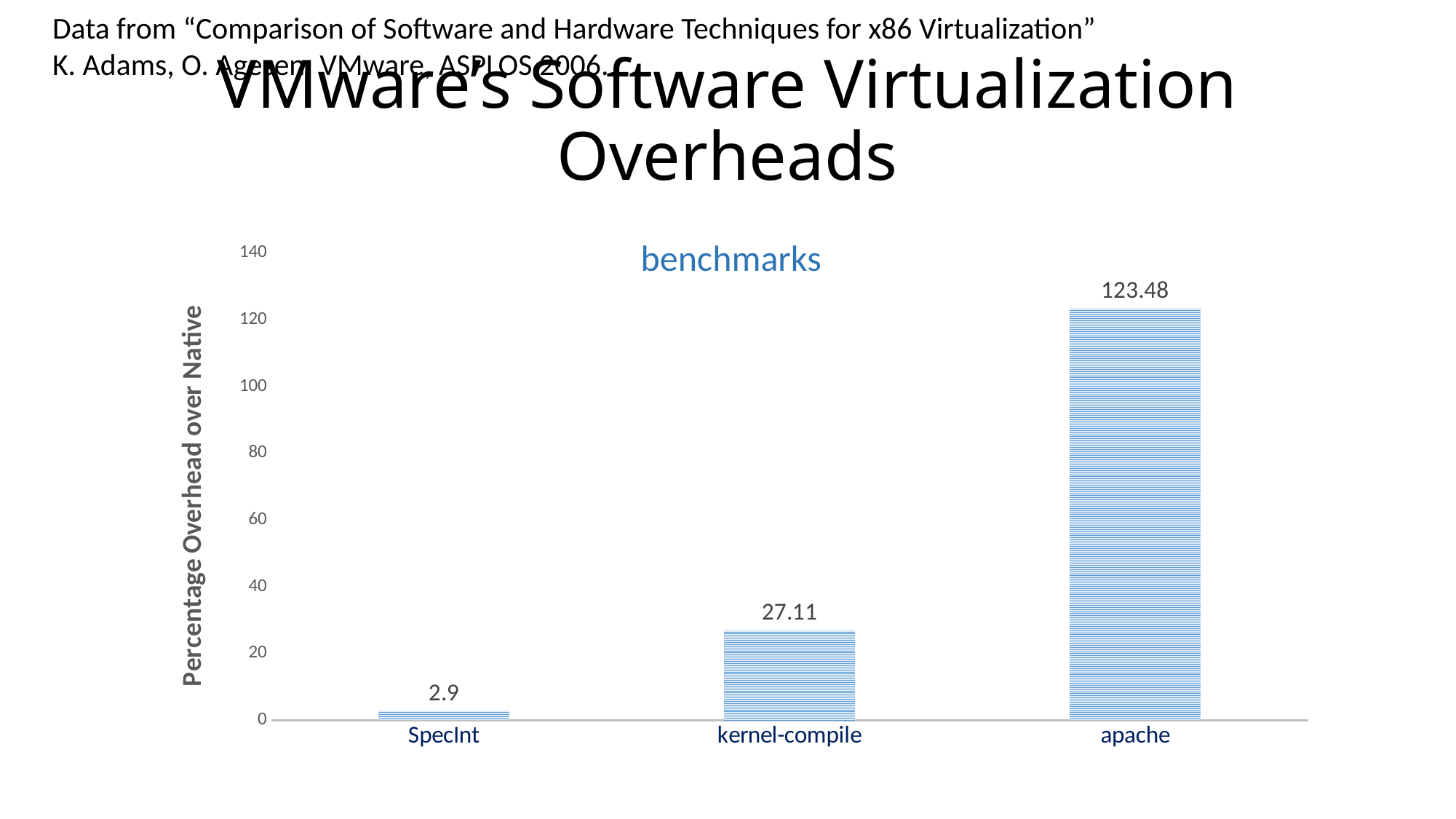
What is the value for apache? 123.48 What is the difference between the values for kernel-compile and SpecInt? 24.21 What is the difference between the values for apache and kernel-compile? 96.37 What is the value for kernel-compile? 27.11 Is the value for apache greater or less than 120? greater Which benchmark has the lowest percentage overhead over native? SpecInt How many benchmarks are shown on the x axis? 3 What is the value for SpecInt? 2.9 Which benchmark has the highest percentage overhead over native? apache What kind of chart is shown on the slide? bar chart What is the label of the y axis? Percentage Overhead over Native Which is larger, the value for kernel-compile or the value for SpecInt? kernel-compile